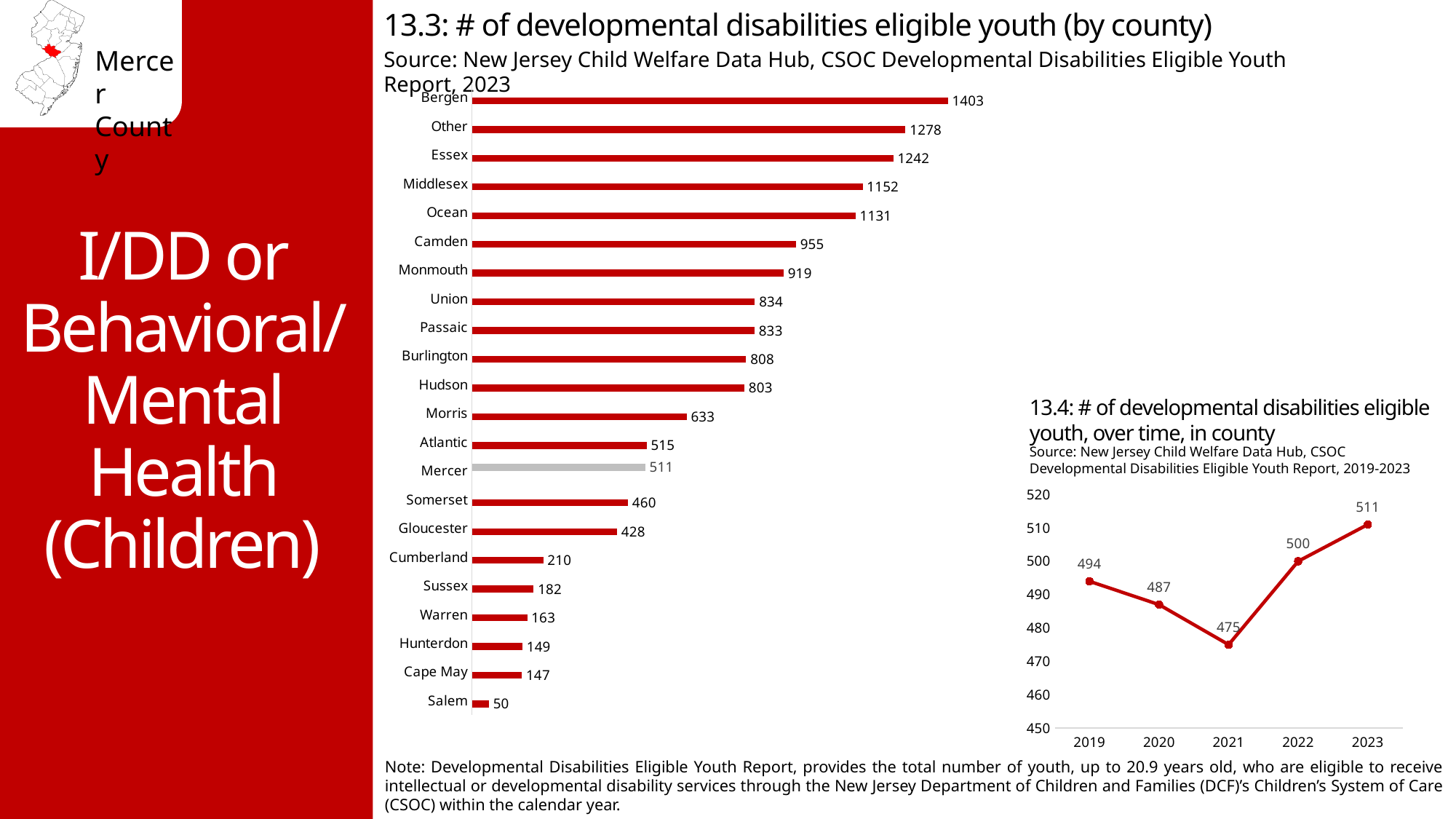
In chart 13.4 (over time, in county), which year has the highest value? 2023 In chart 13.3 (by county), which county has the highest number of developmental disabilities eligible youth? Bergen In chart 13.3 (by county), which bar is shown in a different colour (grey) from the others? Mercer In chart 13.4 (over time, in county), what is the value for 2021? 475 In chart 13.3 (by county), which county has the lowest number of developmental disabilities eligible youth? Salem In chart 13.3 (by county), which has a larger value, Morris or Atlantic? Morris What kind of chart is chart 13.3 (# of developmental disabilities eligible youth by county)? Bar chart In chart 13.3 (by county), how many counties/categories are shown? 22 In chart 13.3 (by county), what is the difference between the values for Bergen and Mercer? 892 In chart 13.4 (over time, in county), what is the difference between the 2023 and 2019 values? 17 In chart 13.3 (# of developmental disabilities eligible youth by county), what is the value for Mercer? 511 In chart 13.3 (by county), what is the value for Camden? 955